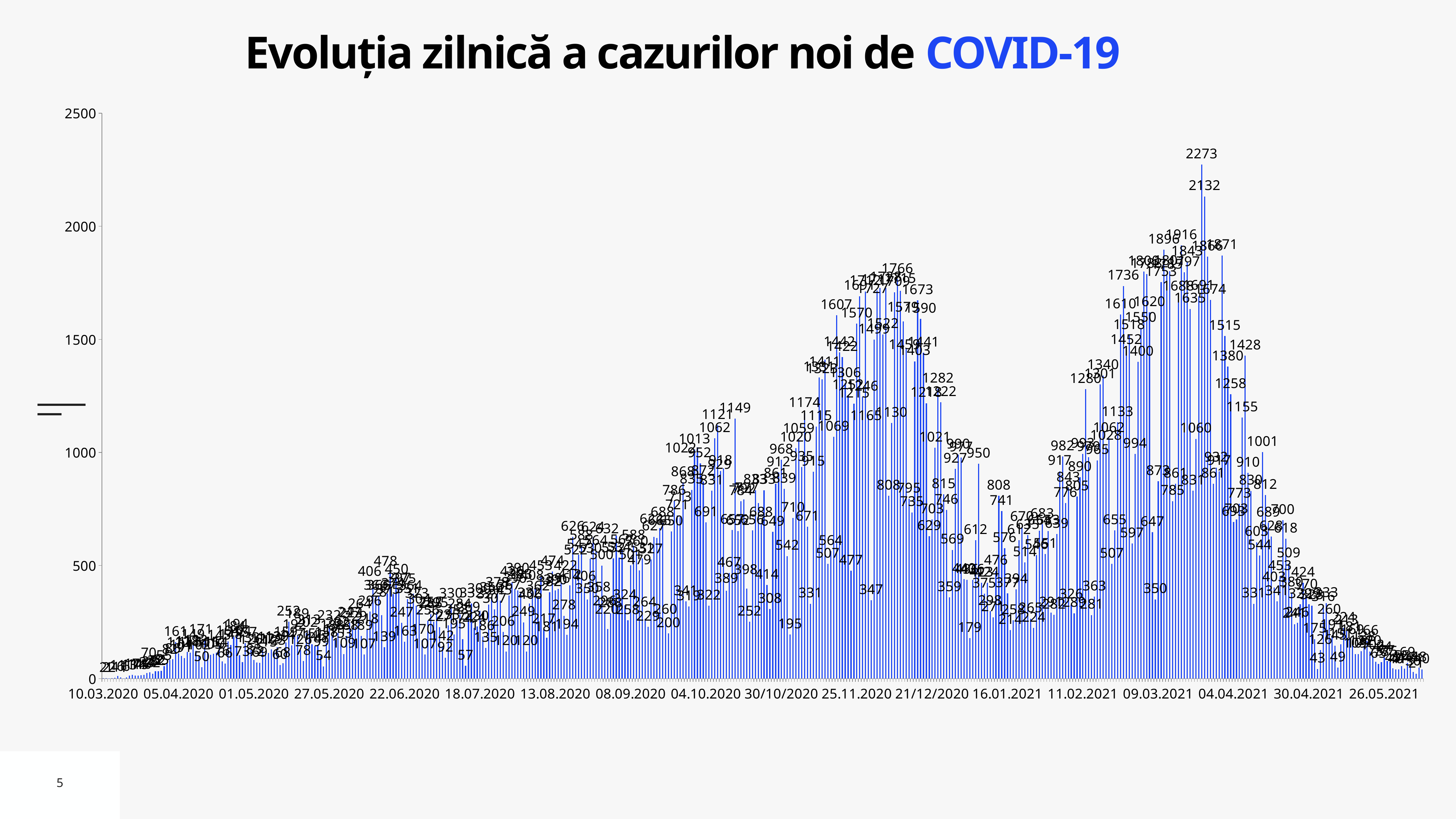
What is the title of the chart? Evoluția zilnică a cazurilor noi de COVID-19 What is the maximum value shown on the vertical axis? 2500 Do the values rise or fall between 10.03.2020 and 22.06.2020? rise Is the value for 10.03.2020 greater or less than 500? less Is the highest value on the chart greater or less than 2000? greater What is the highest daily value labeled on the chart? 2273 What is the second highest daily value labeled on the chart? 2132 What is the difference between the two highest labeled values, 2273 and 2132? 141 Is the value for 26.05.2021 greater or less than 500? less Do the values rise or fall between 04.04.2021 and 26.05.2021? fall Which is larger, the peak value around 25.11.2020 or the peak value around 04.04.2021? the peak around 04.04.2021 What kind of chart is shown on the slide? bar chart